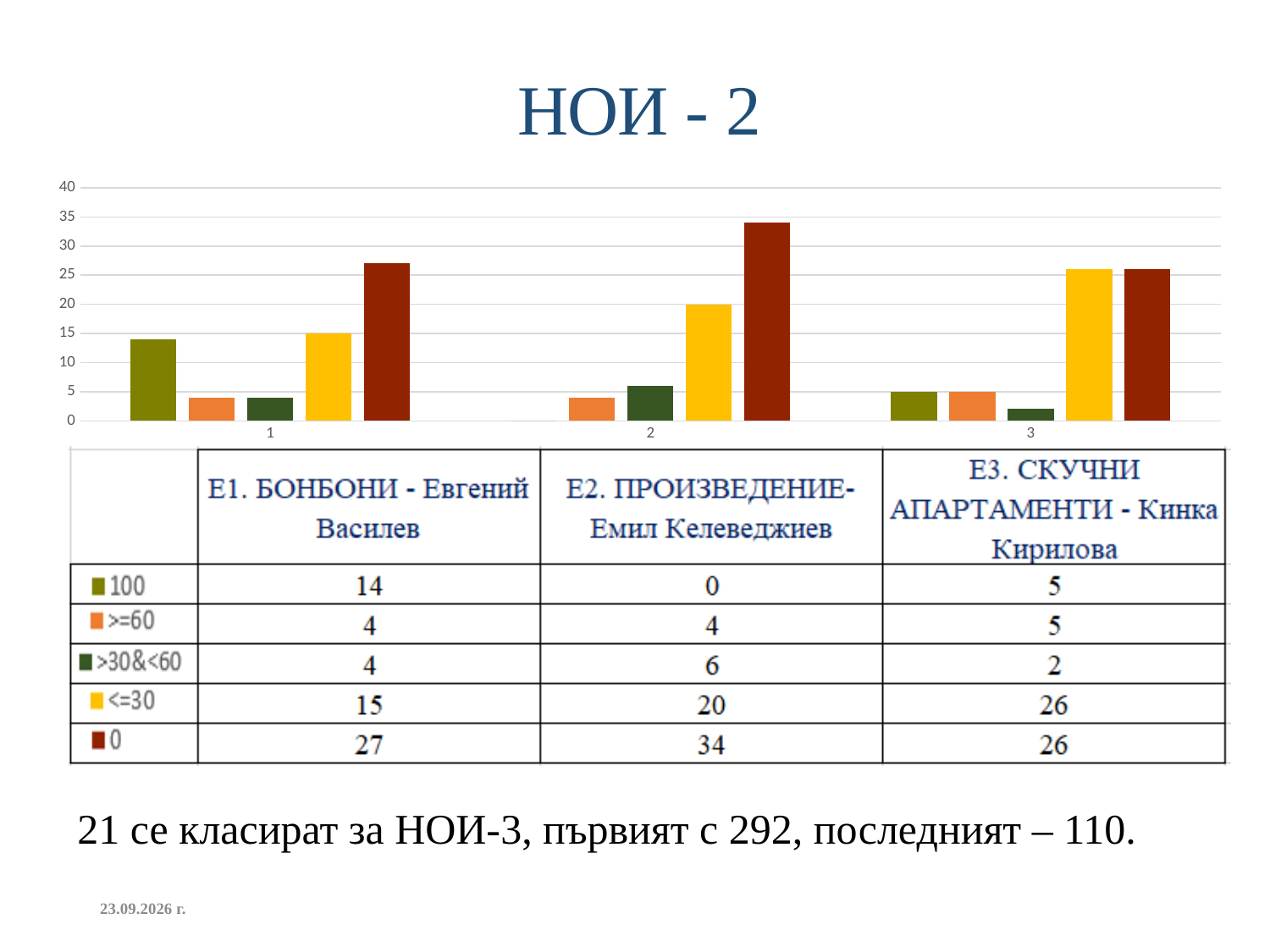
Which is larger for category 1: the "<=30" series or the "100" series? <=30 What is the value of the "0" series for category 2 (E2. ПРОИЗВЕДЕНИЕ - Емил Келеведжиев)? 34 What is the difference between the "0" series values for category 2 and category 1? 7 What is the value of the "100" series for category 1 (E1. БОНБОНИ - Евгений Василев)? 14 Which category has the lowest value in the "100" series? 2 (E2. ПРОИЗВЕДЕНИЕ - Емил Келеведжиев) How many categories are shown on the x axis of the chart? 3 What is the title of the slide containing the chart? НОИ - 2 How many series does the legend (data table) list? 5 What is the value of the "<=30" series for category 3 (E3. СКУЧНИ АПАРТАМЕНТИ - Кинка Кирилова)? 26 What kind of chart is shown on the slide? bar chart Which category has the highest value in the "0" series? 2 (E2. ПРОИЗВЕДЕНИЕ - Емил Келеведжиев) Is the value of the "0" series for category 2 greater or less than 30? greater